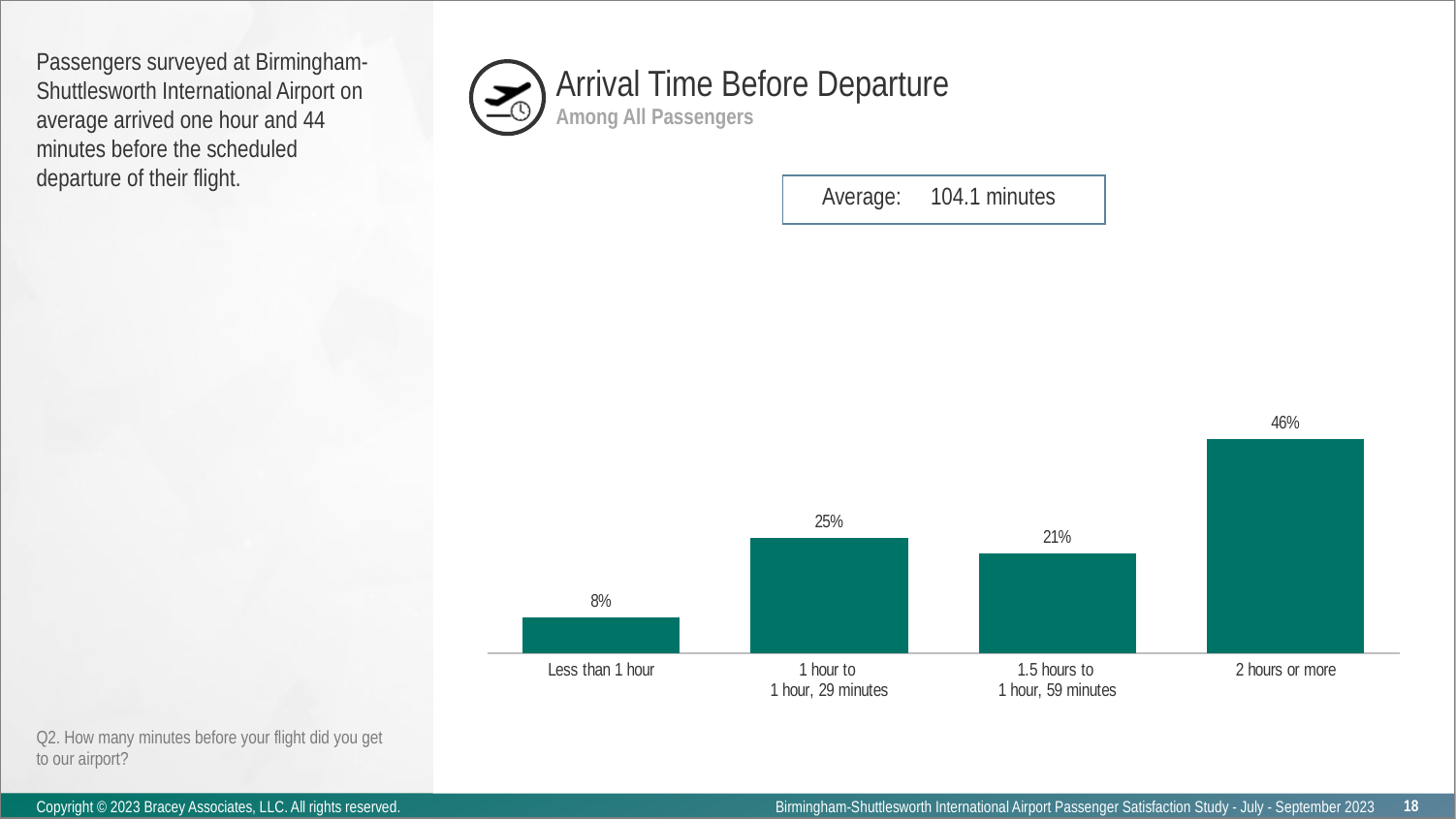
Which arrival time category has the lowest percentage of passengers? Less than 1 hour What type of chart is shown on the slide? Bar chart What is the average arrival time before departure shown on the slide? 104.1 minutes Which arrival time category has the highest percentage of passengers? 2 hours or more How many arrival time categories are shown in the chart? 4 What is the difference in percentage points between the '2 hours or more' category and the 'Less than 1 hour' category? 38 What percentage of passengers arrived 1.5 hours to 1 hour, 59 minutes before departure? 21% What percentage of passengers arrived less than 1 hour before departure? 8% Which category has a larger share: '1 hour to 1 hour, 29 minutes' or '1.5 hours to 1 hour, 59 minutes'? 1 hour to 1 hour, 29 minutes What is the title of the chart? Arrival Time Before Departure What percentage of passengers arrived 2 hours or more before departure? 46% What percentage of passengers arrived 1 hour to 1 hour, 29 minutes before departure? 25%